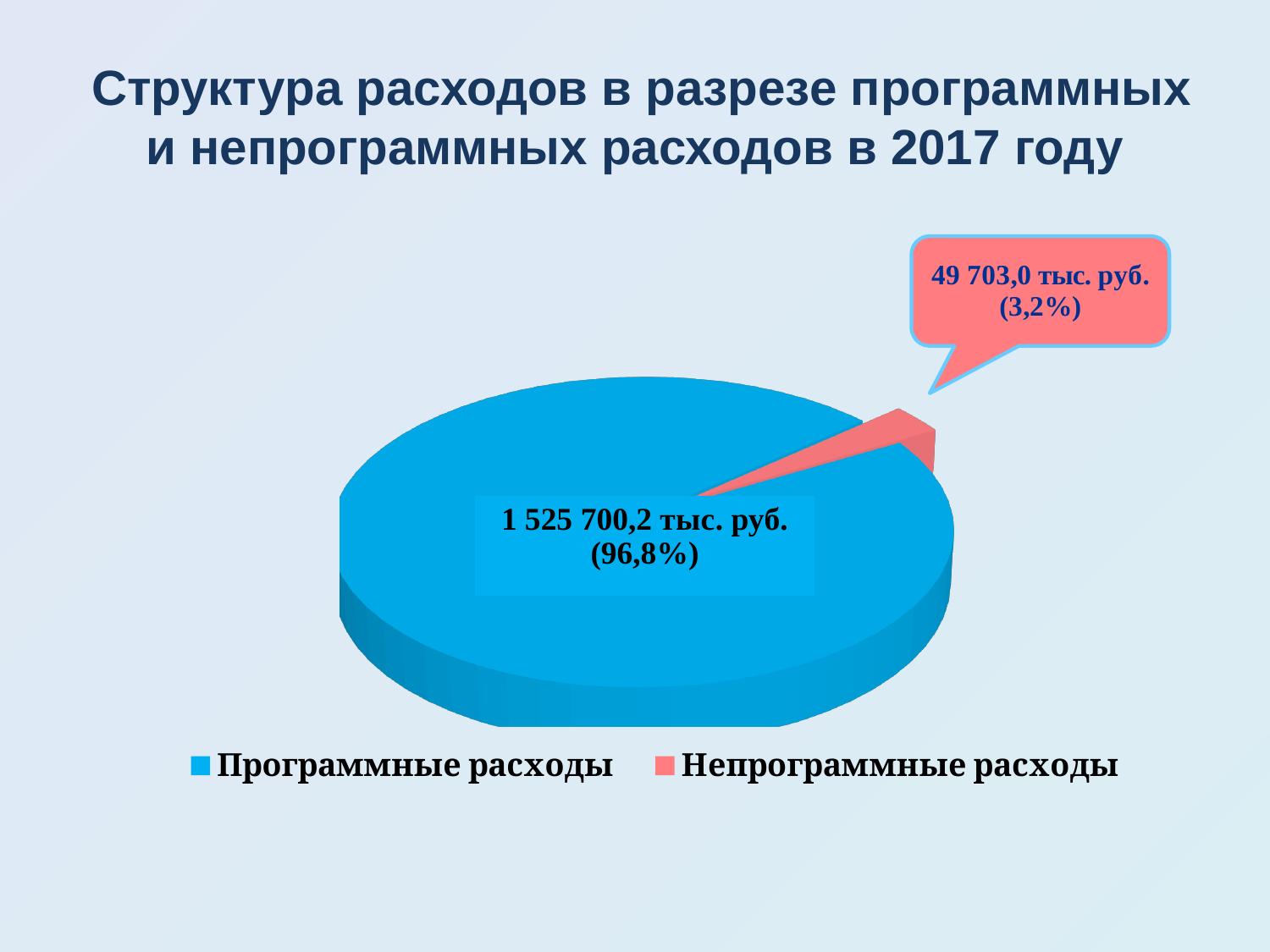
How many slices does the pie chart have? 2 What is the difference between Программные расходы and Непрограммные расходы in тыс. руб.? 1 475 997,2 тыс. руб. What is the value for Программные расходы? 1 525 700,2 тыс. руб. What kind of chart is shown on the slide? pie chart What colour is the slice for Непрограммные расходы? red (pink) What is the value for Непрограммные расходы? 49 703,0 тыс. руб. Which category has the largest slice of the pie? Программные расходы What share of the pie does Программные расходы take? 96,8% What share of the pie does Непрограммные расходы take? 3,2% Which category has the smallest slice of the pie? Непрограммные расходы How many entries does the legend list? 2 Which is larger, Программные расходы or Непрограммные расходы? Программные расходы